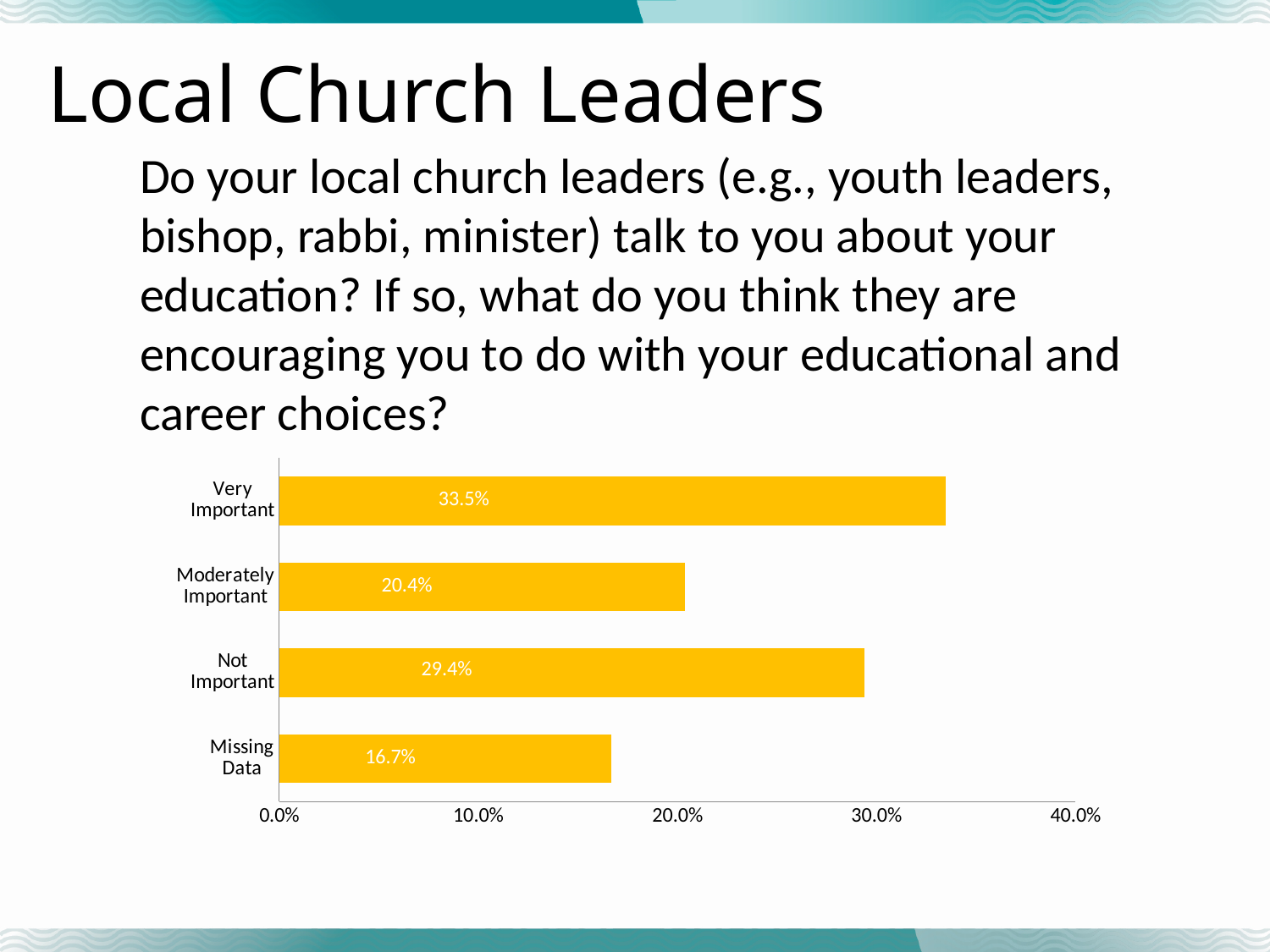
Which category has the lowest value? Missing Data Which category has the highest value? Very Important What is the value for Moderately Important? 20.4% What is the value for Missing Data? 16.7% What kind of chart is shown on the slide? bar chart Is the value for Very Important greater or less than 30.0%? greater What is the value for Not Important? 29.4% How many categories are shown in the chart? 4 What is the difference between the values for Very Important and Not Important? 4.1% What is the difference between the values for Moderately Important and Missing Data? 3.7% What is the value for Very Important? 33.5% Which is larger, the value for Moderately Important or the value for Not Important? Not Important